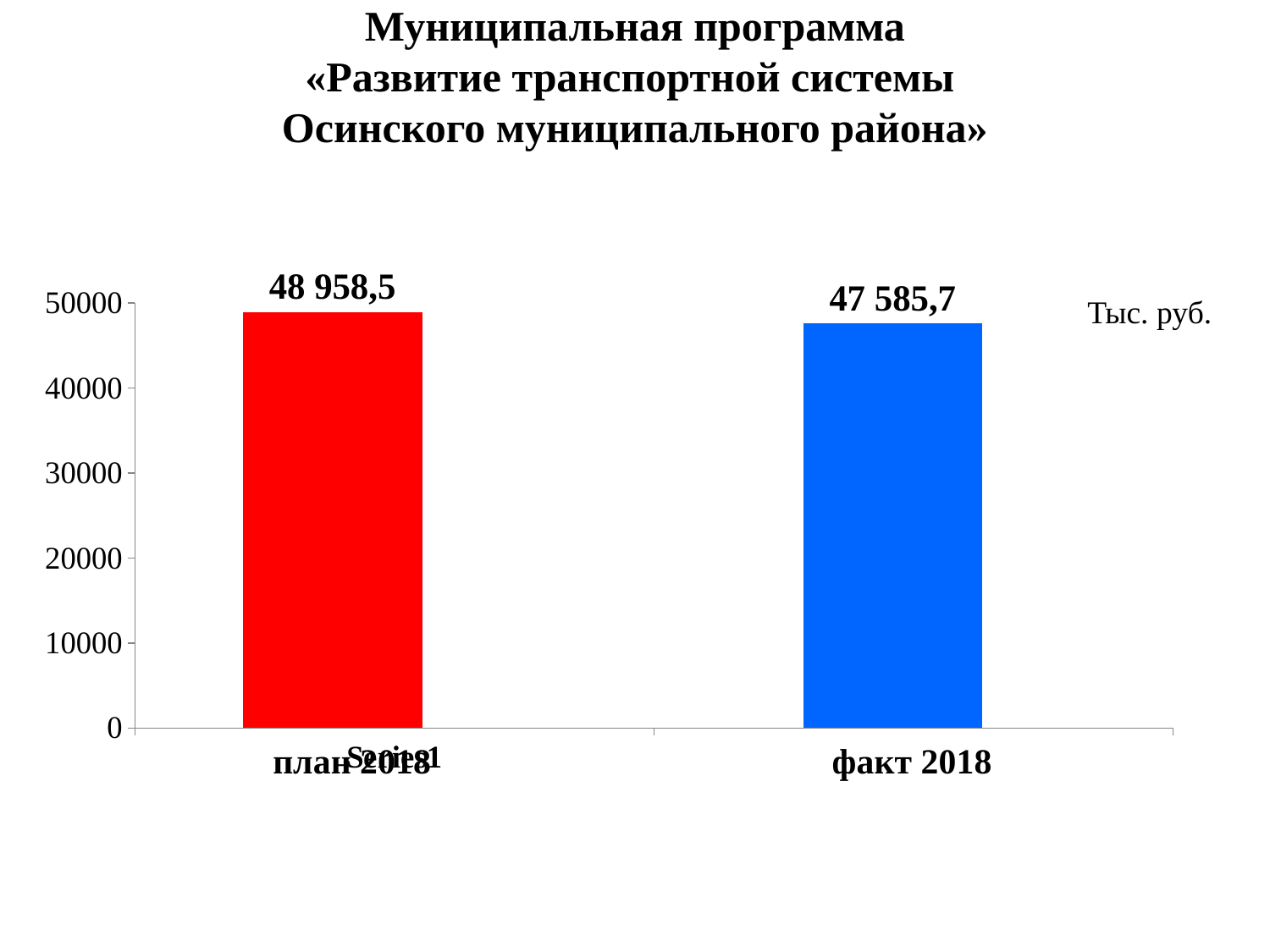
What is the value for факт 2018? 47 585,7 How many categories are shown on the chart? 2 What is the value for план 2018? 48 958,5 Which category has the highest value? план 2018 What is the difference between the values for план 2018 and факт 2018? 1 372,8 Which category has the lowest value? факт 2018 Is the value for факт 2018 greater or less than 50000? less Which is larger, the value for план 2018 or the value for факт 2018? план 2018 Is the value for план 2018 greater or less than 40000? greater What kind of chart is shown on the slide? bar chart What unit of measurement is indicated next to the chart? Тыс. руб. What colour is the bar for факт 2018? blue